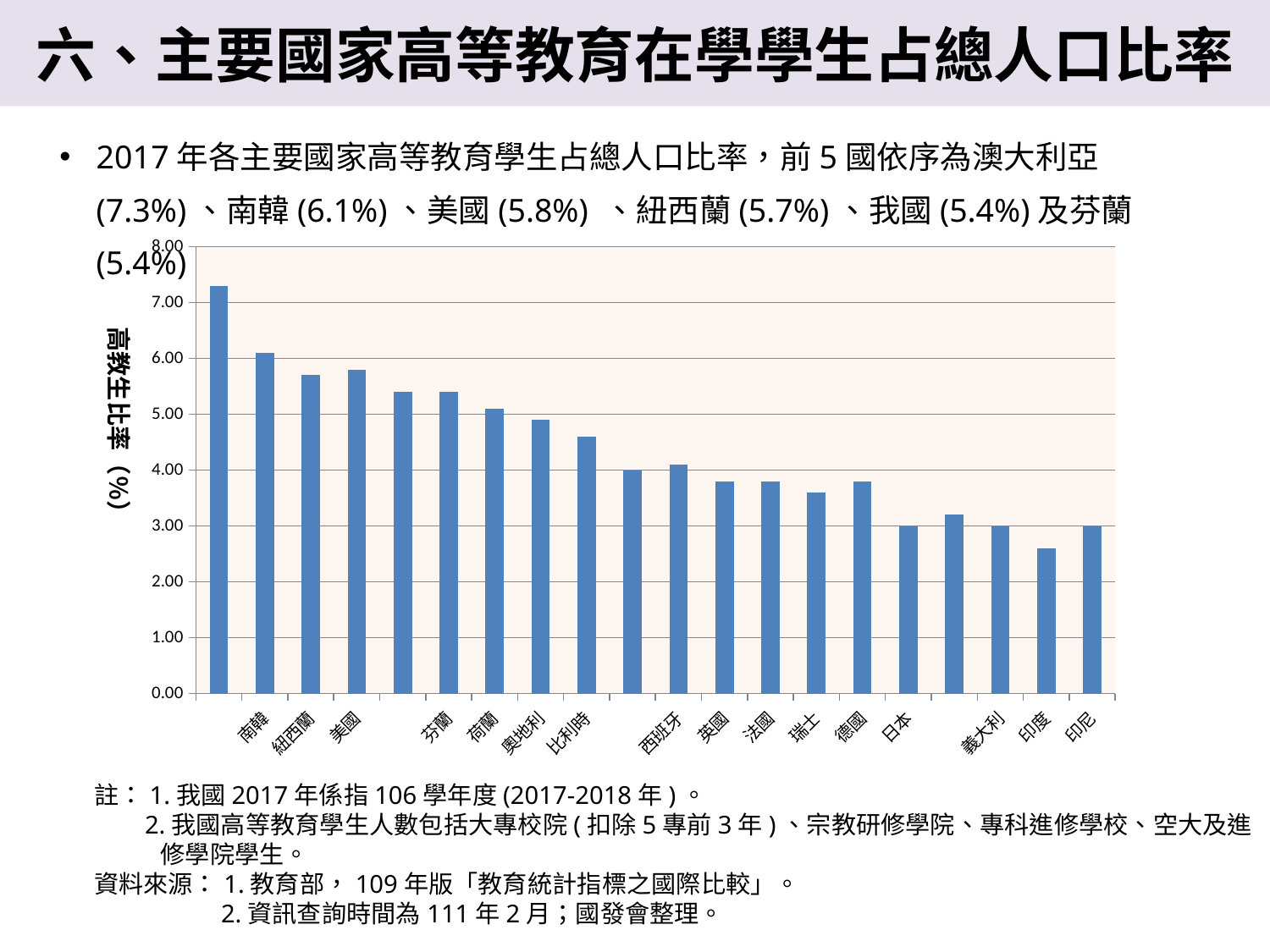
Which country has the highest higher-education student ratio in the chart? 澳大利亞 What is the higher-education student ratio for 南韓 in 2017? 6.1% What is the difference between the ratios of 南韓 and 美國? 0.3 percentage points Do the bar values generally rise or fall from left to right along the x axis? fall Which country has the lowest higher-education student ratio in the chart? 印度 Is the value for 印度 greater or less than 3.00? less What is the higher-education student ratio for 紐西蘭 in 2017? 5.7% Which has a higher ratio, 印度 or 印尼? 印尼 How many countries (bars) are plotted in the chart? 20 What is the title of the vertical axis of the chart? 高教生比率(%) What kind of chart is shown on the slide? bar chart Is the value for 比利時 greater or less than 4.00? greater